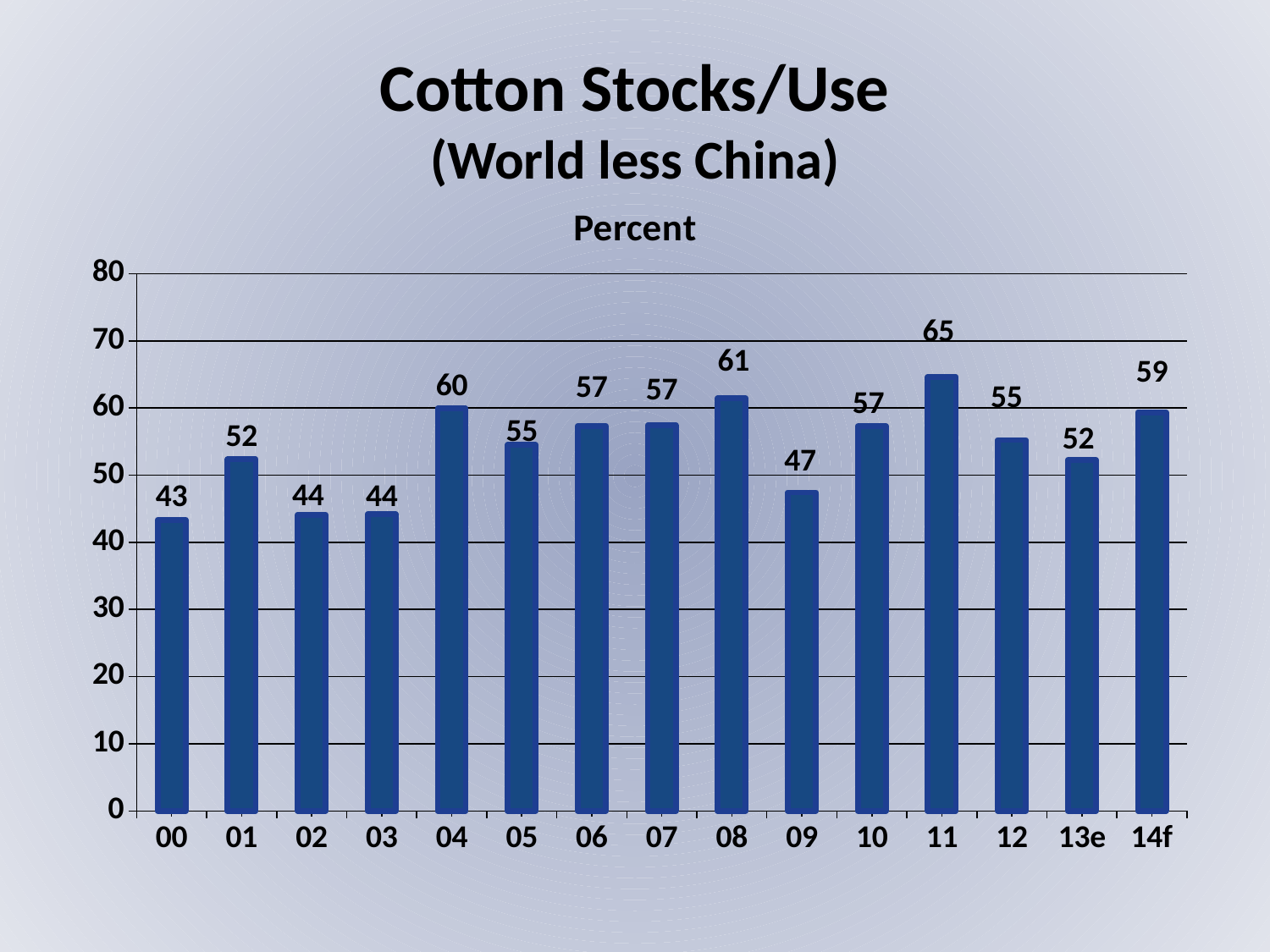
Which year has the highest stocks/use value? 11 How many years are shown on the x axis? 15 Which is larger, the value for 08 or the value for 12? 08 What is the value shown for 14f? 59 What is the title of the chart? Cotton Stocks/Use (World less China) What is the difference between the values for 11 and 09? 18 Do the values rise or fall from 08 to 09? fall What kind of chart is this? bar chart Is the value for 04 greater or less than 50? greater Which year has the lowest stocks/use value? 00 What is the value shown for 00? 43 What is the cotton stocks/use value for 11? 65